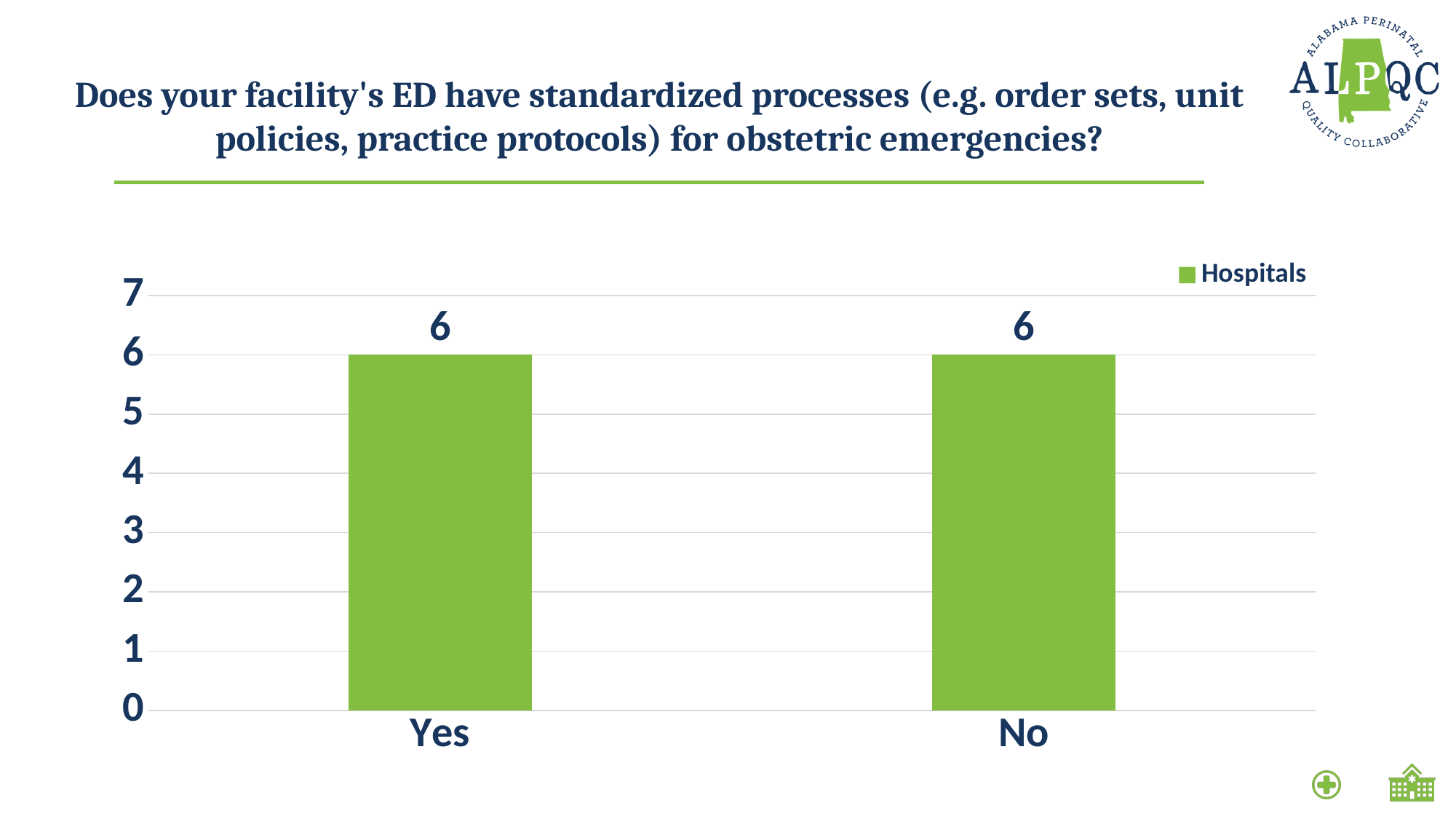
What colour are the bars? green Is the value for Yes greater or less than 5? greater What series name is shown in the legend? Hospitals What is the difference between the values for Yes and No? 0 What is the value for Yes? 6 What is the value for No? 6 What kind of chart is shown? bar chart What is the total of the values for Yes and No? 12 Is the value for No greater or less than 7? less How many categories are shown on the x axis? 2 How many series does the legend list? 1 What is the highest value shown on the y axis? 7